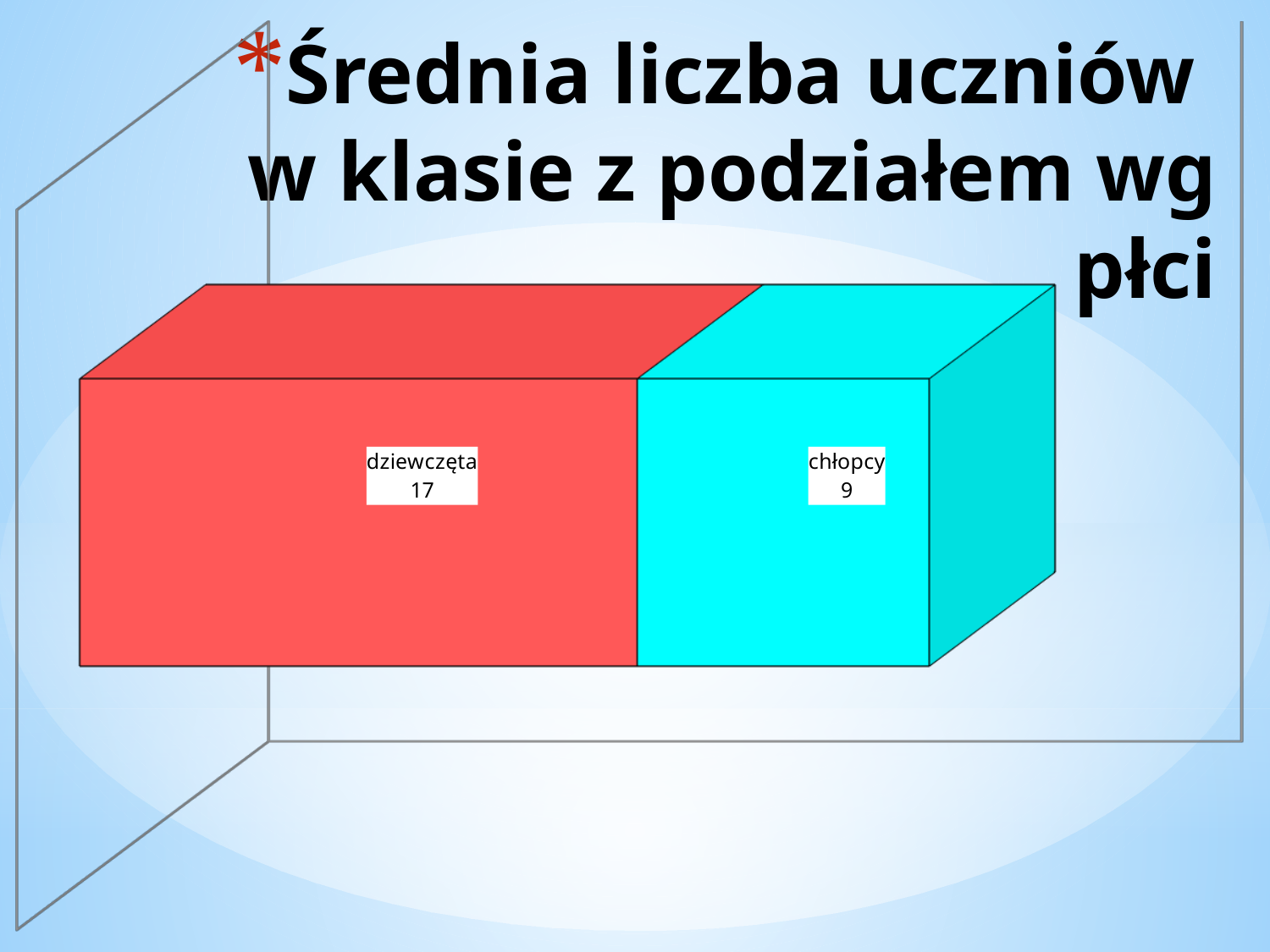
What kind of chart is shown on the slide? Stacked bar chart Which group has the higher value, dziewczęta or chłopcy? dziewczęta Which segment of the bar has the smallest value? chłopcy What is the title of the slide containing the chart? Średnia liczba uczniów w klasie z podziałem wg płci What is the value shown for dziewczęta? 17 Which segment of the bar has the largest value? dziewczęta How many segments make up the stacked bar? 2 What colour is the segment for chłopcy? Cyan What is the value shown for chłopcy? 9 What is the difference between the values for dziewczęta and chłopcy? 8 What is the total of the stacked bar (dziewczęta plus chłopcy)? 26